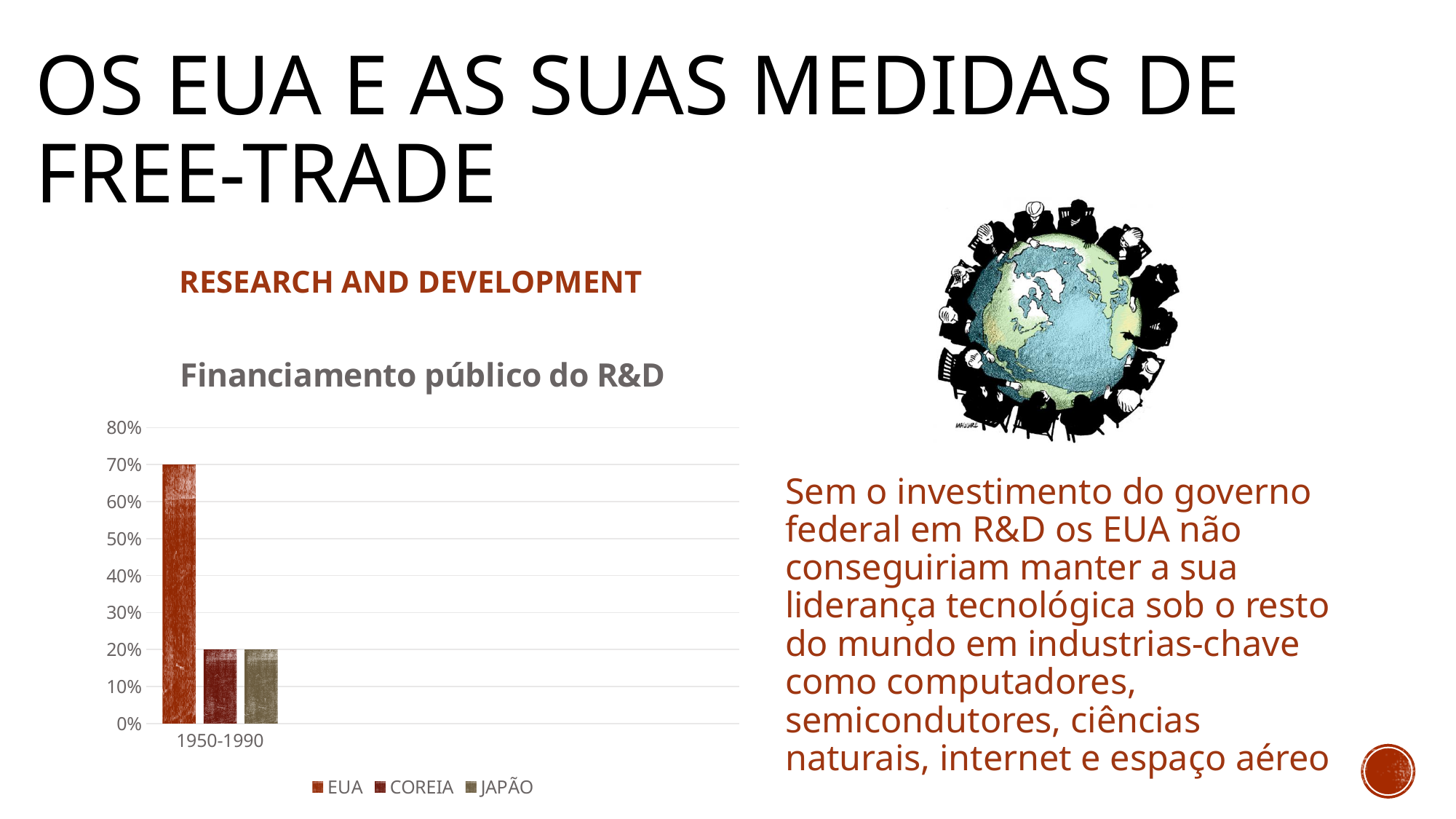
What is the difference between the values for EUA and COREIA in the chart? 50% Which series has the highest value in the chart? EUA What is the value for EUA in the chart? 70% Is the value for EUA greater or less than 60%? greater What type of chart is shown under the title "Financiamento público do R&D"? bar chart What is the value for JAPÃO in the chart? 20% What is the category label on the x axis of the chart? 1950-1990 How many categories are shown on the x axis of the chart? 1 Which series are listed in the chart's legend? EUA, COREIA, JAPÃO What is the value for COREIA in the chart? 20% What is the title of the chart on the slide? Financiamento público do R&D How many series does the legend of the chart list? 3